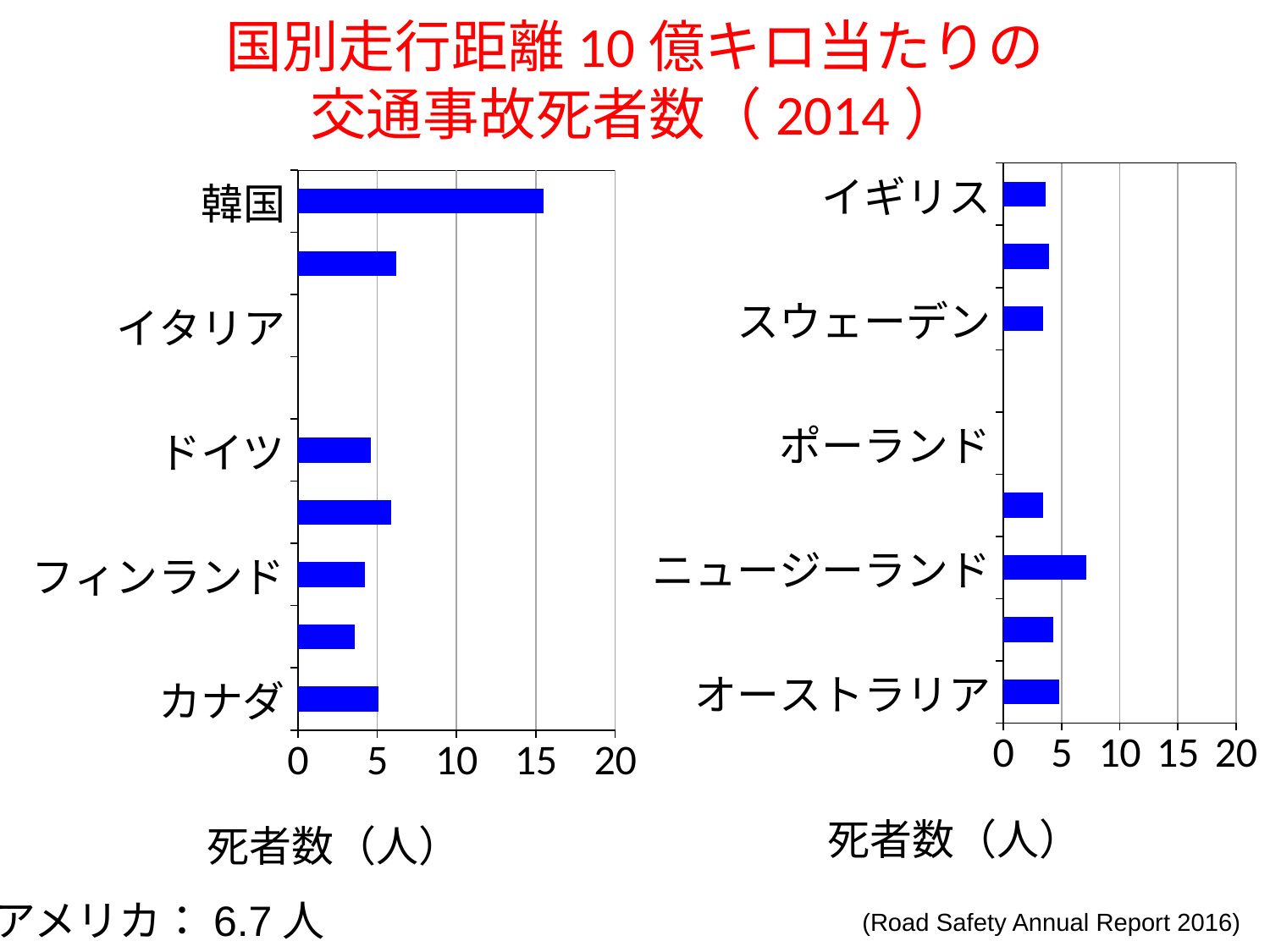
In the left chart, is the value for ドイツ greater or less than 5? less What is the x-axis label of the left chart? 死者数（人） In the right chart, is the value for ニュージーランド greater or less than 5? greater What type of chart is shown on the left side of the slide? bar chart In the right chart, is the value for イギリス greater or less than 5? less In the left chart, which is larger, the value for 韓国 or the value for ドイツ? 韓国 What is the maximum value shown on the x axis of the right chart? 20 In the right chart, which is larger, the value for ニュージーランド or the value for スウェーデン? ニュージーランド In the left chart, which labeled country has the highest value? 韓国 In the right chart, which labeled country has the highest value? ニュージーランド